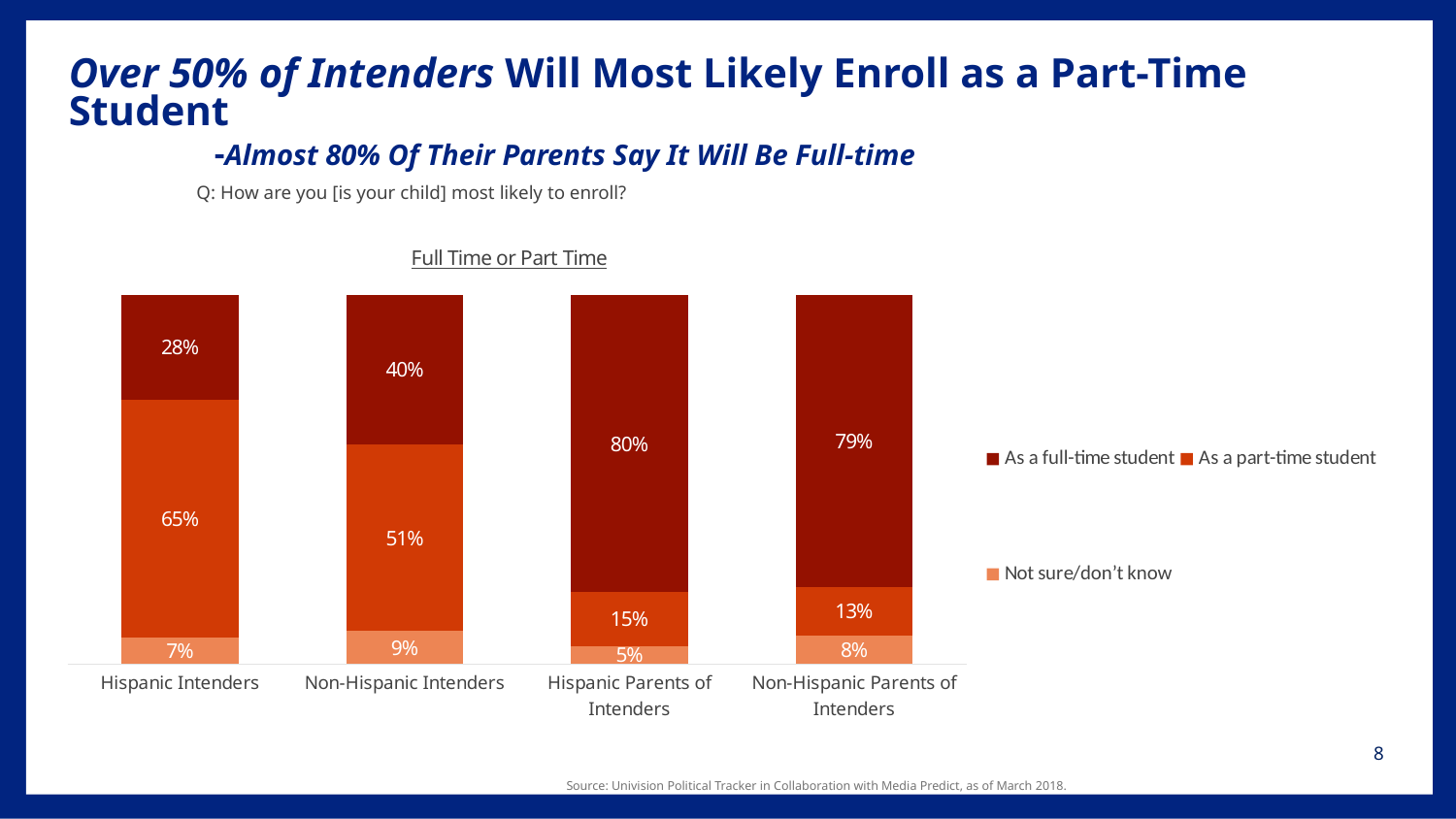
What percentage of Hispanic Parents of Intenders are not sure/don't know? 5% What is the difference between the full-time student percentages for Non-Hispanic Intenders and Hispanic Intenders? 12% What is the title of the chart? Full Time or Part Time What percentage of Hispanic Intenders say they will most likely enroll as a part-time student? 65% How many categories are shown on the x axis of the chart? 4 What percentage of Non-Hispanic Parents of Intenders say their child will enroll as a part-time student? 13% What kind of chart is shown on the slide? Stacked bar chart Which is larger: the part-time student percentage for Hispanic Intenders or for Non-Hispanic Intenders? Hispanic Intenders Which category has the lowest value for 'As a part-time student'? Non-Hispanic Parents of Intenders How many series does the legend list? 3 What percentage of Non-Hispanic Intenders say they will most likely enroll as a full-time student? 40% Which category has the highest value for 'As a full-time student'? Hispanic Parents of Intenders